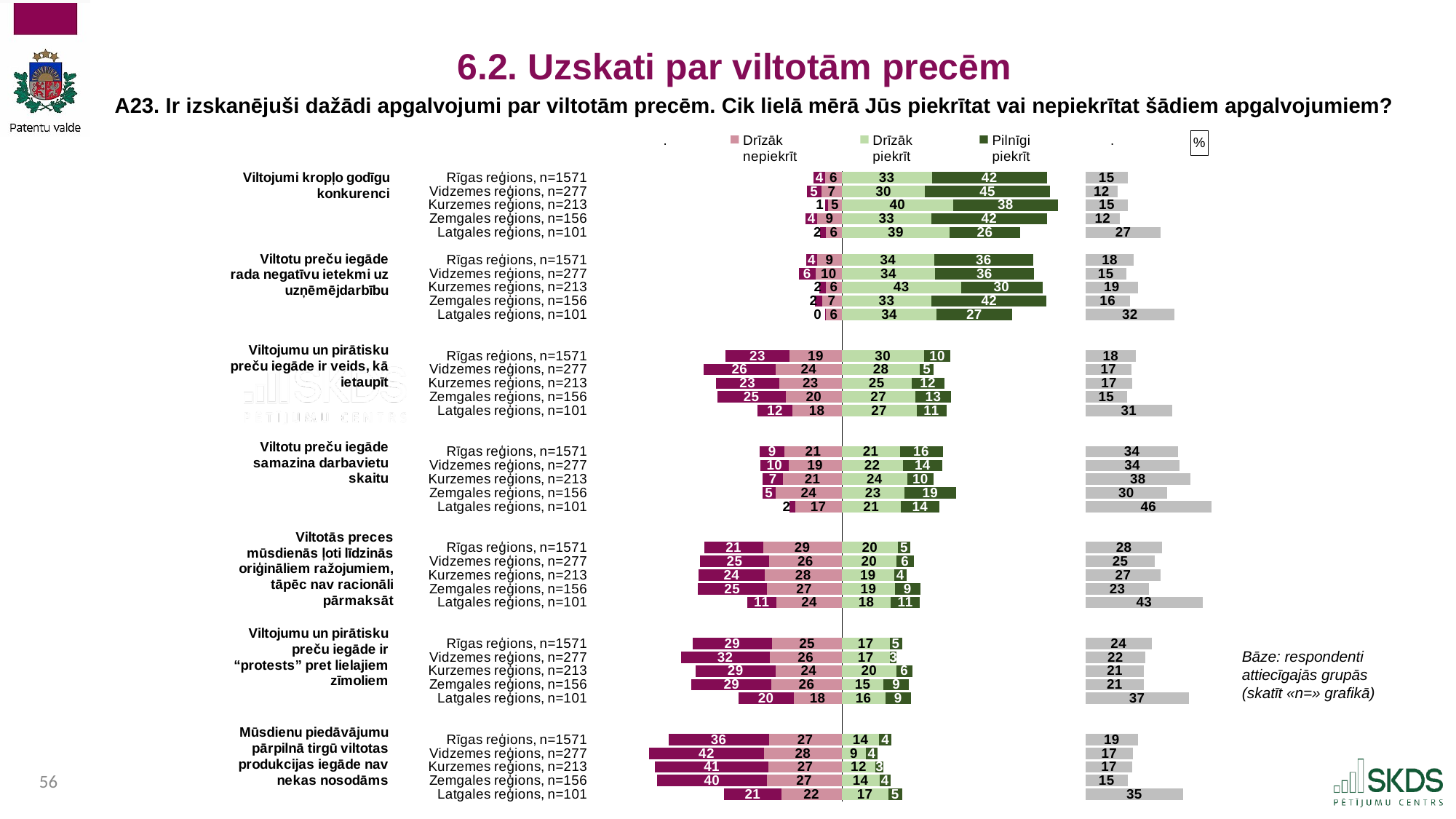
For the statement "Mūsdienu piedāvājumu pārpilnā tirgū viltotas produkcijas iegāde nav nekas nosodāms", which region has the highest dark purple (leftmost) segment value? Vidzemes reģions, n=277 For the statement "Viltojumi kropļo godīgu konkurenci", what is the total of all segments (including the grey bar) for Rīgas reģions, n=1571? 100 What kind of chart is shown on the slide? Stacked bar chart For the statement "Viltojumi kropļo godīgu konkurenci", what is the difference between the "Pilnīgi piekrīt" values for Rīgas reģions and Latgales reģions? 16 For the statement "Viltojumi kropļo godīgu konkurenci", which region has the highest "Pilnīgi piekrīt" value? Vidzemes reģions, n=277 For the statement "Viltotu preču iegāde samazina darbavietu skaitu", what is the grey bar value for Latgales reģions, n=101? 46 How many regions are shown for each statement in the chart? 5 For the statement "Viltojumi kropļo godīgu konkurenci", which region has the lowest "Pilnīgi piekrīt" value? Latgales reģions, n=101 For the statement "Viltojumu un pirātisku preču iegāde ir veids, kā ietaupīt", which has the larger "Drīzāk piekrīt" value: Rīgas reģions or Vidzemes reģions? Rīgas reģions For the statement "Viltotu preču iegāde rada negatīvu ietekmi uz uzņēmējdarbību", what is the "Drīzāk piekrīt" value for Kurzemes reģions, n=213? 43 For the statement "Viltojumi kropļo godīgu konkurenci", what is the "Pilnīgi piekrīt" value for Vidzemes reģions, n=277? 45 What colour does the legend use for "Pilnīgi piekrīt"? Dark green